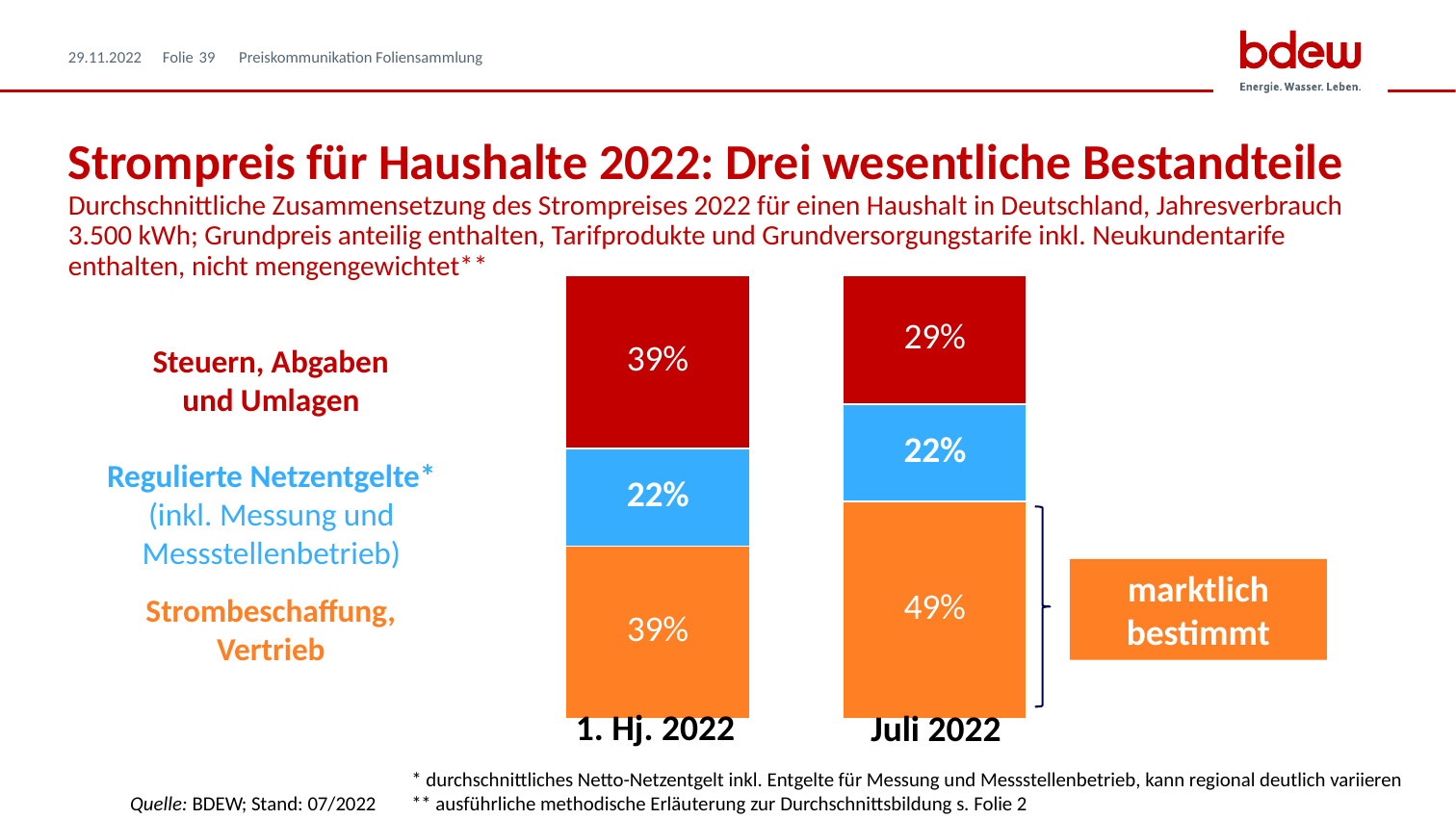
What type of chart is shown on the slide? Stacked bar chart What share of the household electricity price in 1. Hj. 2022 is Regulierte Netzentgelte? 22% Which component is the largest in the Juli 2022 bar? Strombeschaffung, Vertrieb What share of the household electricity price in Juli 2022 is Strombeschaffung, Vertrieb? 49% What share of the household electricity price in Juli 2022 is Steuern, Abgaben und Umlagen? 29% Which component is the smallest in the 1. Hj. 2022 bar? Regulierte Netzentgelte What share of the household electricity price in 1. Hj. 2022 is Steuern, Abgaben und Umlagen? 39% By how many percentage points did the share of Strombeschaffung, Vertrieb change from 1. Hj. 2022 to Juli 2022? 10 percentage points Is the share of Steuern, Abgaben und Umlagen larger in 1. Hj. 2022 or in Juli 2022? 1. Hj. 2022 How many bars (time periods) does the chart show? 2 How many components make up each stacked bar? 3 Which component of the electricity price is labelled as 'marktlich bestimmt'? Strombeschaffung, Vertrieb